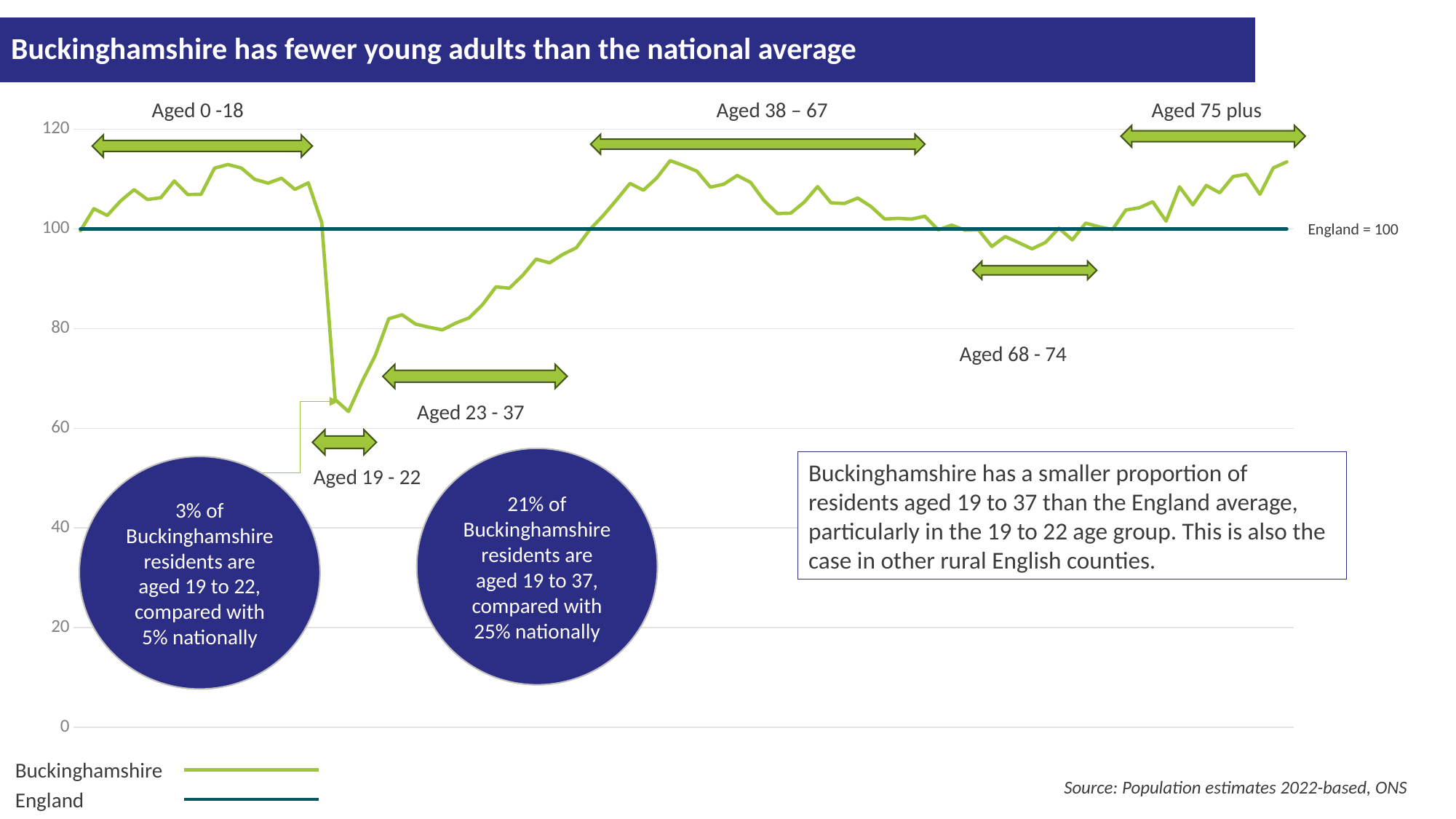
What are the two series named in the legend? Buckinghamshire and England How many age-group ranges are labelled with arrows on the chart? 6 What kind of chart is shown on the slide? line chart Is the Buckinghamshire value in the Aged 19 - 22 range greater or less than 80? less Is the Buckinghamshire line in the Aged 23 - 37 range greater or less than 100? less What is the title of the slide? Buckinghamshire has fewer young adults than the national average Which labelled age group has the lowest Buckinghamshire value on the chart? Aged 19 - 22 Does the Buckinghamshire line rise or fall across the Aged 23 - 37 range? rise Is the Buckinghamshire line in the Aged 68 - 74 range greater or less than 100? less What value is the England line set at on the chart? 100 How many series does the legend list? 2